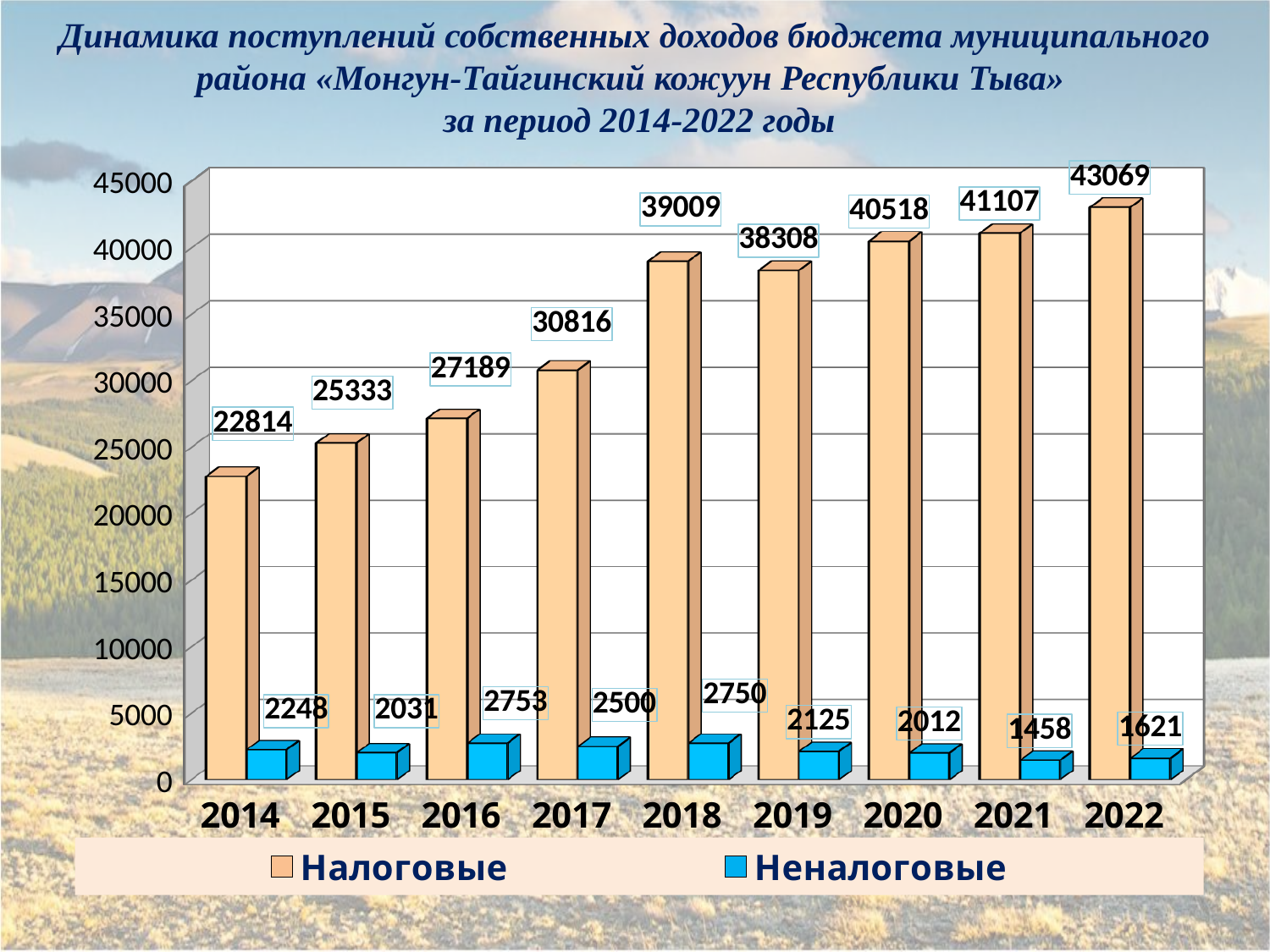
In which year is the Неналоговые value lowest? 2021 How many series does the legend list? 2 How many years are shown on the x axis? 9 What is the value of Неналоговые for 2016? 2753 What kind of chart is shown on the slide? bar chart What is the value of Налоговые for 2018? 39009 Which series is shown in blue in the legend? Неналоговые In which year is the Налоговые value highest? 2022 What is the difference between the Налоговые values for 2022 and 2014? 20255 Is the Налоговые value for 2017 greater or less than 30000? greater What is the value of Налоговые for 2022? 43069 Which is larger, the Налоговые value for 2018 or for 2019? 2018